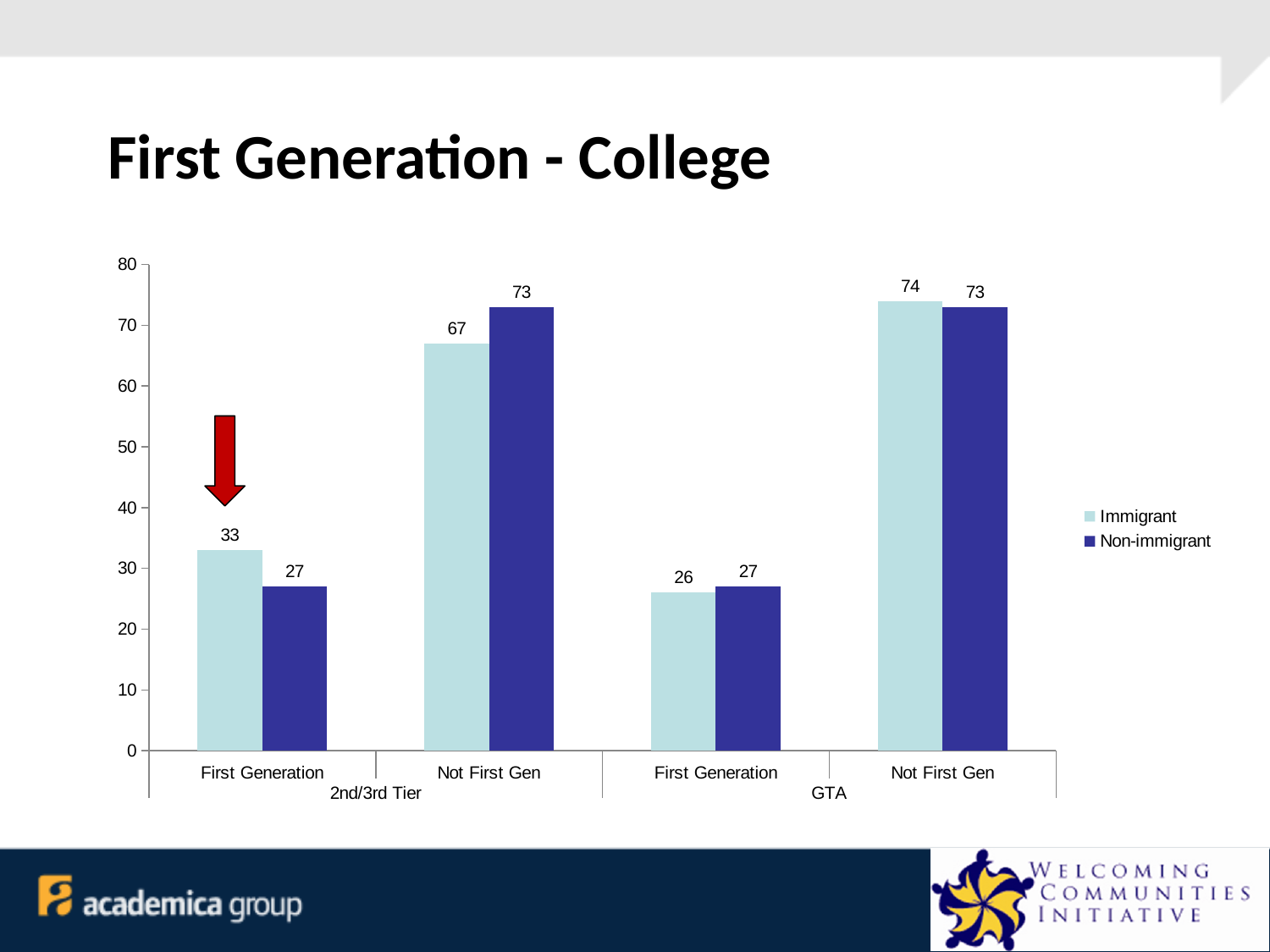
Which bar has the highest value on the chart? Immigrant, Not First Gen, GTA (74) What is the Immigrant value for First Generation in the GTA group? 26 For Not First Gen in the 2nd/3rd Tier group, which is larger: the Immigrant value or the Non-immigrant value? Non-immigrant What is the difference between the Immigrant values for Not First Gen in the GTA group and the 2nd/3rd Tier group? 7 Which series is shown in light blue in the legend? Immigrant What is the Non-immigrant value for Not First Gen in the GTA group? 73 What is the difference between the Immigrant and Non-immigrant values for First Generation in the 2nd/3rd Tier group? 6 What is the Non-immigrant value for Not First Gen in the 2nd/3rd Tier group? 73 What is the Immigrant value for First Generation in the 2nd/3rd Tier group? 33 What kind of chart is shown on the slide? Bar chart How many series does the legend list? 2 Which bar has the lowest value on the chart? Immigrant, First Generation, GTA (26)